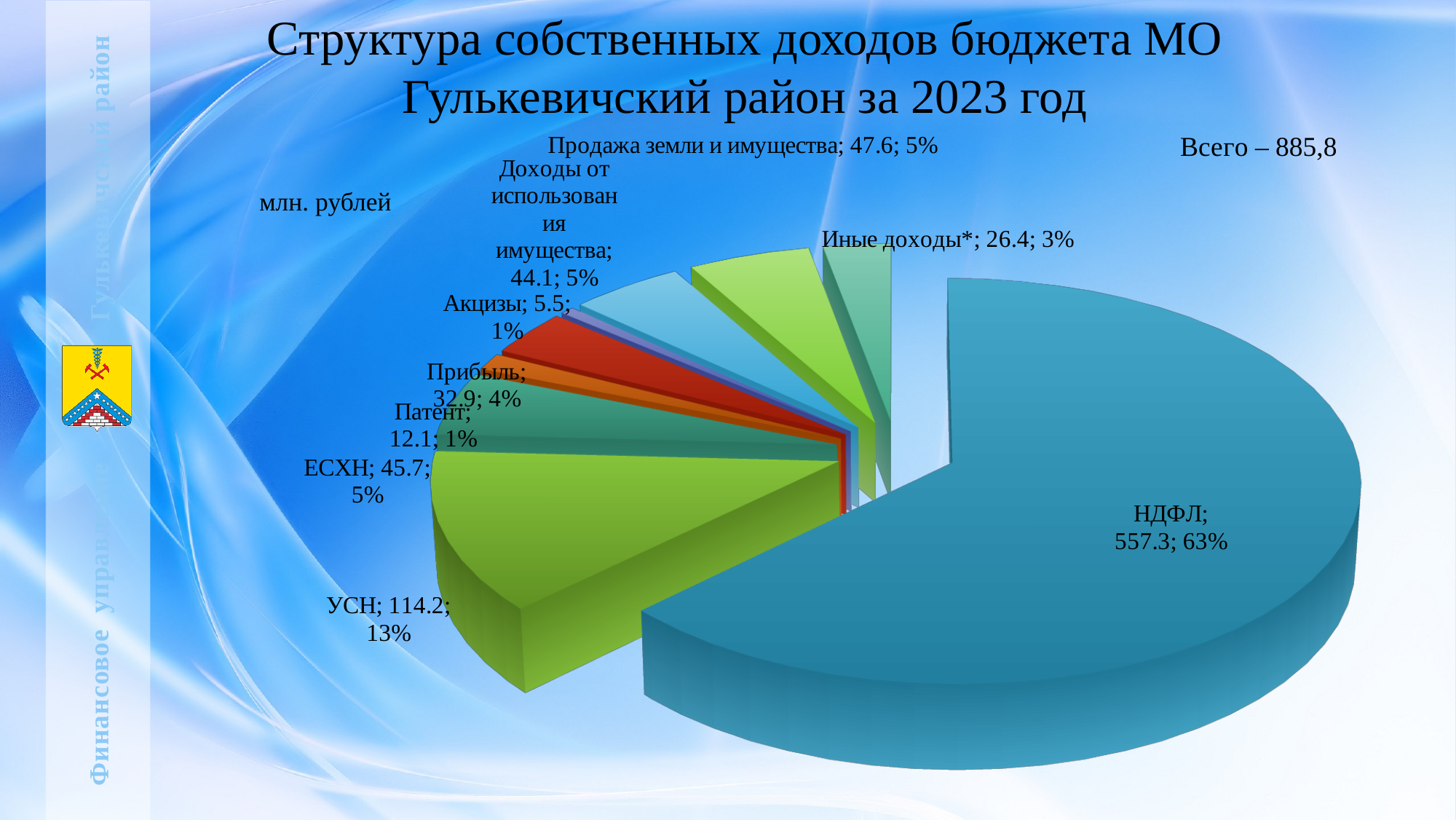
What is the value for Продажа земли и имущества? 47.6 Which category has the largest slice of the pie? НДФЛ What share of the pie does Доходы от использования имущества take? 5% Which category has the smallest slice of the pie? Акцизы What is the value for НДФЛ? 557.3 What is the difference between the values for УСН and Прибыль? 81.3 What share of the pie does УСН take? 13% What total (Всего) is stated on the slide? 885,8 What is the value for ЕСХН? 45.7 Which is larger, the value for Патент or the value for Иные доходы*? Иные доходы* What kind of chart is shown on the slide? pie chart How many slices does the pie chart have? 9